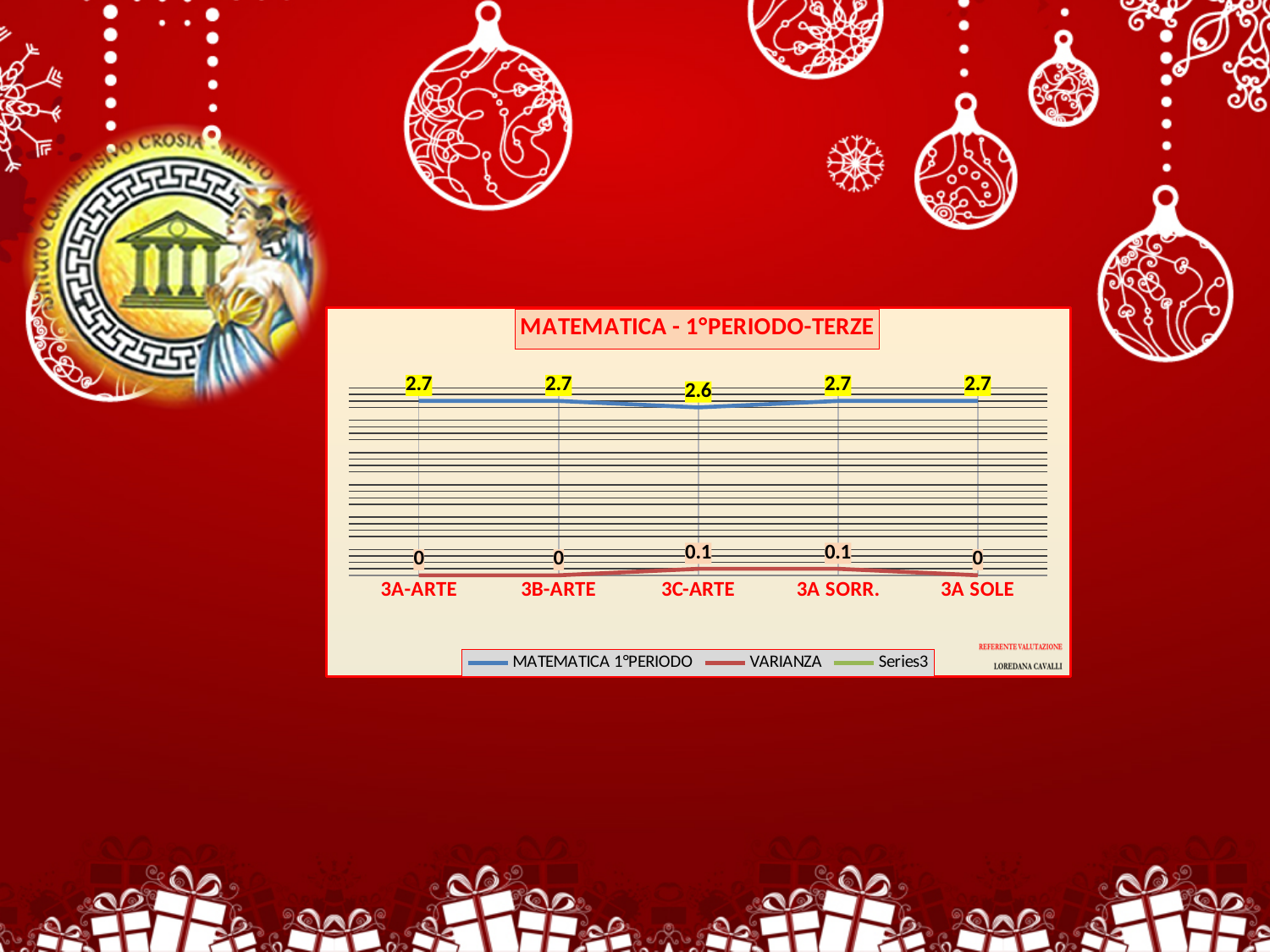
What is the VARIANZA value for 3A SOLE? 0 What is the VARIANZA value for 3C-ARTE? 0.1 How many categories are shown on the x axis of the chart? 5 What is the title of the chart? MATEMATICA - 1°PERIODO-TERZE What is the MATEMATICA 1°PERIODO value for 3A SORR.? 2.7 Which is larger, the VARIANZA value for 3A SORR. or for 3B-ARTE? 3A SORR. What is the difference between the MATEMATICA 1°PERIODO values for 3A-ARTE and 3C-ARTE? 0.1 What is the MATEMATICA 1°PERIODO value for 3C-ARTE? 2.6 What kind of chart is shown on the slide? line chart Which series is drawn in blue in the chart? MATEMATICA 1°PERIODO How many series does the chart's legend list? 3 Which category has the lowest MATEMATICA 1°PERIODO value? 3C-ARTE